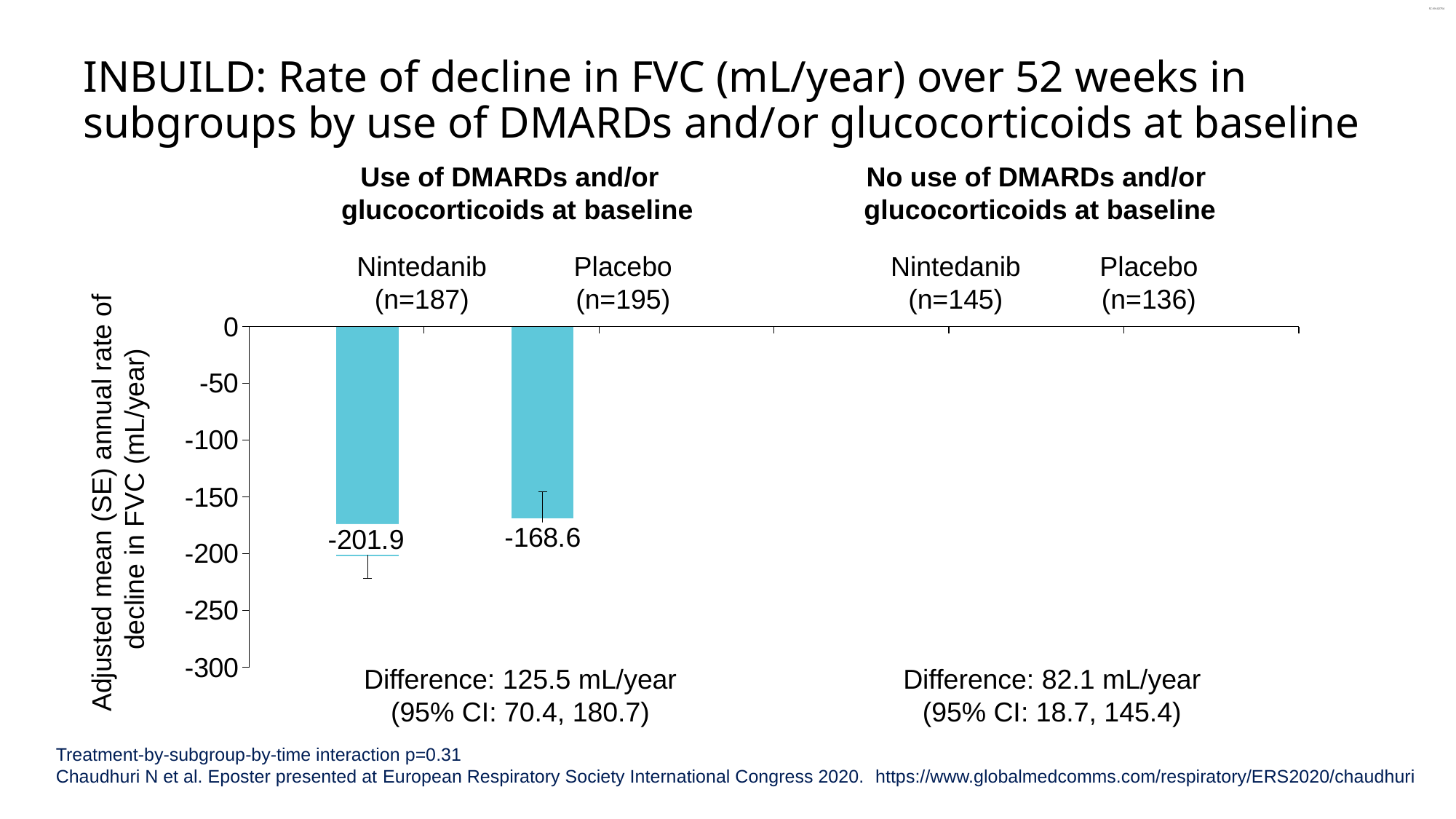
What is the 95% CI given for the difference in the 'Use of DMARDs and/or glucocorticoids at baseline' subgroup? 70.4, 180.7 What difference in rate of decline is stated for the 'Use of DMARDs and/or glucocorticoids at baseline' subgroup? 125.5 mL/year What is the adjusted mean annual rate of decline in FVC for Nintedanib (n=187) in the 'Use of DMARDs and/or glucocorticoids at baseline' subgroup? -201.9 Is the value for Placebo (n=195) in the 'Use of DMARDs' subgroup greater or less than -150? less What difference in rate of decline is stated for the 'No use of DMARDs and/or glucocorticoids at baseline' subgroup? 82.1 mL/year What is the y-axis label of the chart? Adjusted mean (SE) annual rate of decline in FVC (mL/year) How many bars are plotted on the chart? 2 What is the adjusted mean annual rate of decline in FVC for Placebo (n=195) in the 'Use of DMARDs and/or glucocorticoids at baseline' subgroup? -168.6 What is the lowest value shown on the y-axis? -300 What is the 95% CI given for the difference in the 'No use of DMARDs and/or glucocorticoids at baseline' subgroup? 18.7, 145.4 What is the sample size for Nintedanib in the 'No use of DMARDs and/or glucocorticoids at baseline' subgroup? n=145 What kind of chart is shown on the slide? bar chart